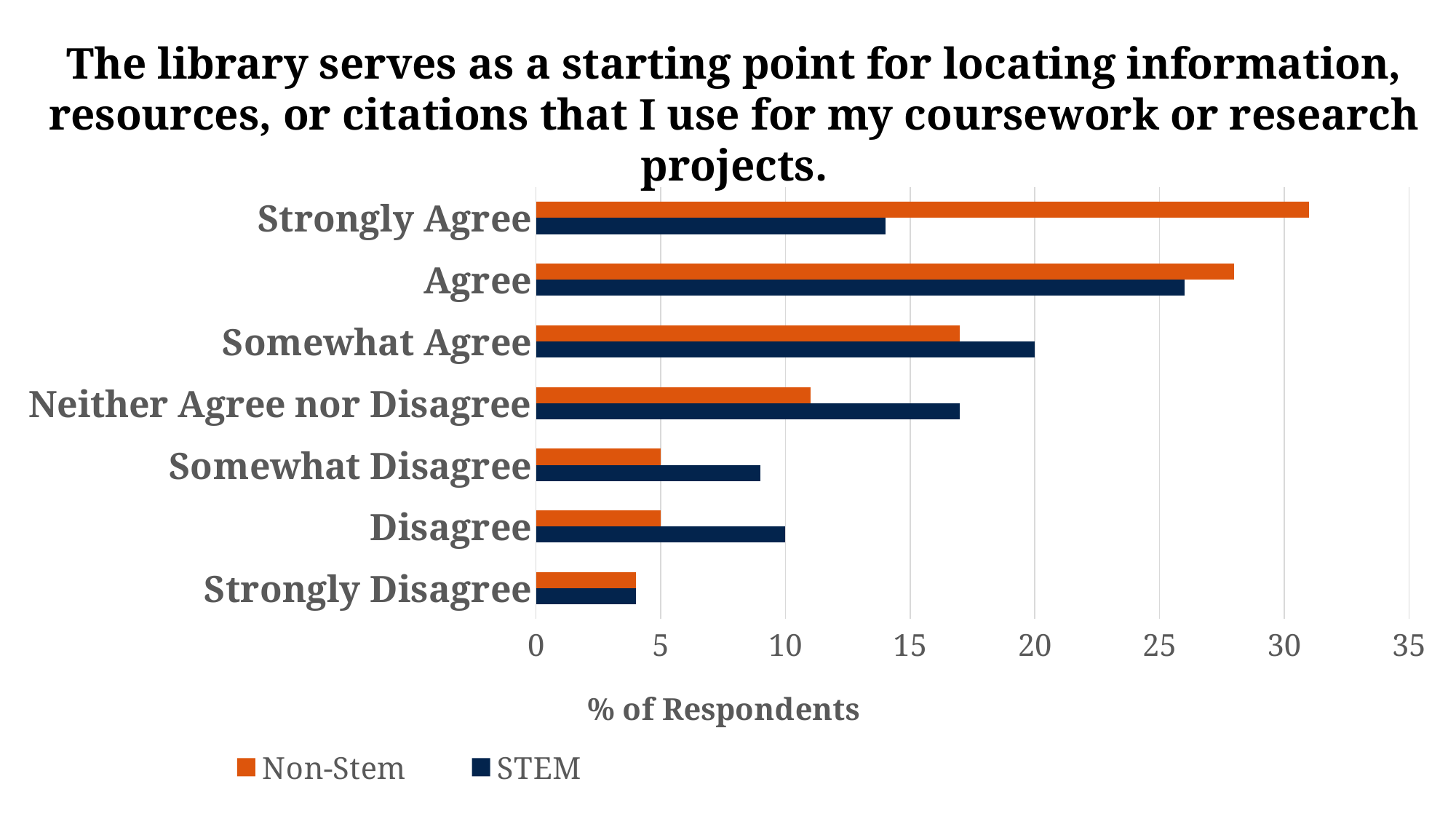
Is the Non-Stem value for Strongly Agree greater or less than 30? greater What kind of chart is shown on the slide? bar chart How many series does the legend list? 2 For Strongly Agree, which series has the larger value, Non-Stem or STEM? Non-Stem For Somewhat Agree, which series has the larger value, Non-Stem or STEM? STEM Which category has the lowest Non-Stem value? Strongly Disagree Which category has the highest Non-Stem value? Strongly Agree How many response categories are shown on the chart? 7 Which category has the highest STEM value? Agree Is the STEM value for Neither Agree nor Disagree greater or less than 15? greater What is the label on the horizontal axis? % of Respondents Is the STEM value for Strongly Agree greater or less than 15? less